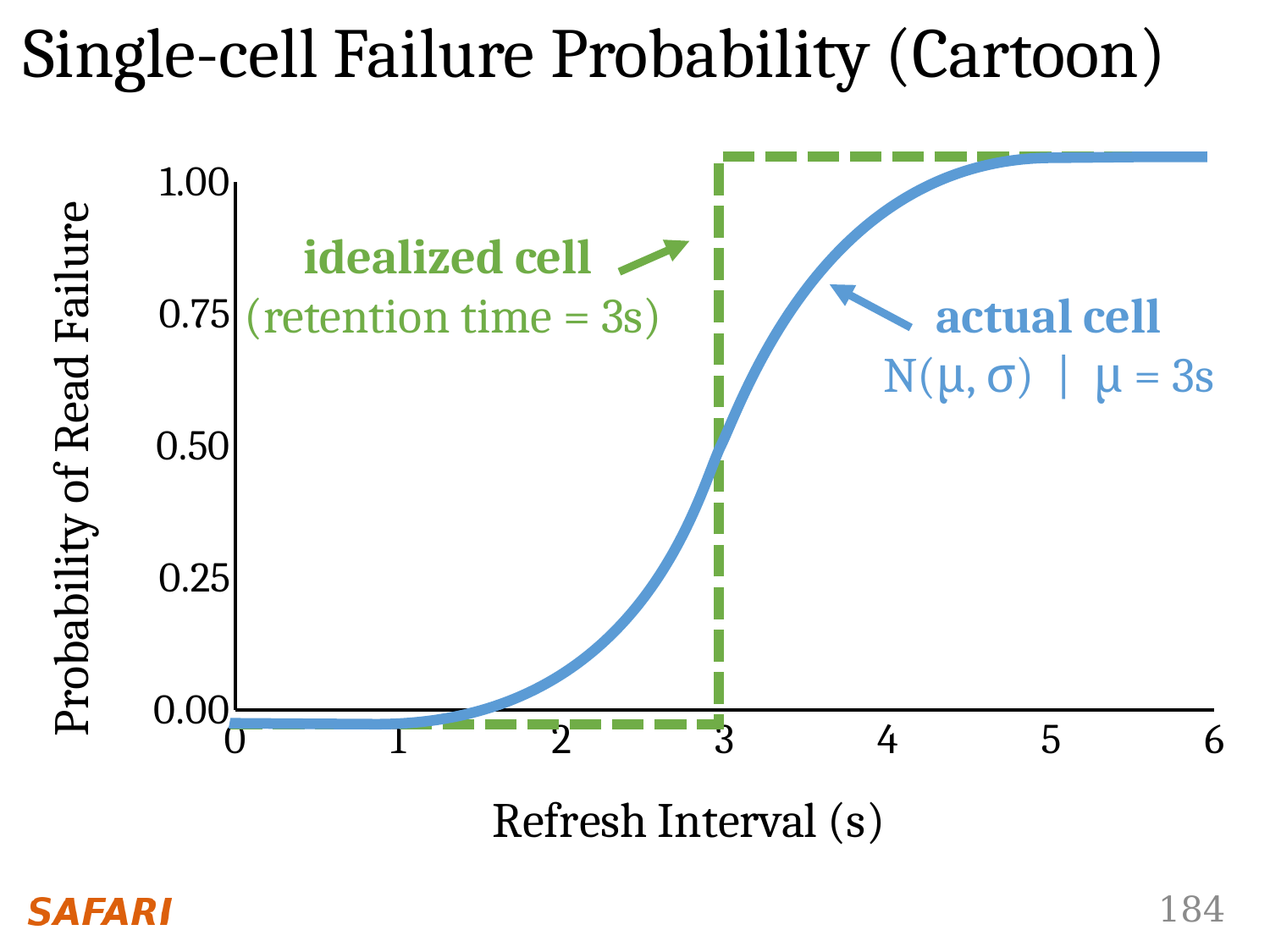
What value of μ is given for the actual cell? 3s What is the title of the chart on the slide? Single-cell Failure Probability (Cartoon) What is the label of the x axis? Refresh Interval (s) What retention time is given for the idealized cell? 3s Is the probability of read failure for the actual cell at a refresh interval of 2 s greater or less than 0.25? less Is the probability of read failure for the idealized cell at a refresh interval of 4 s greater or less than 0.75? greater What kind of chart is shown on the slide? line chart Does the probability of read failure for the actual cell rise or fall as the refresh interval increases? rise Is the probability of read failure for the idealized cell at a refresh interval of 2 s greater or less than 0.25? less How many curves (series) are plotted on the chart? 2 At a refresh interval of 2 s, which curve shows the higher probability of read failure, the actual cell or the idealized cell? actual cell